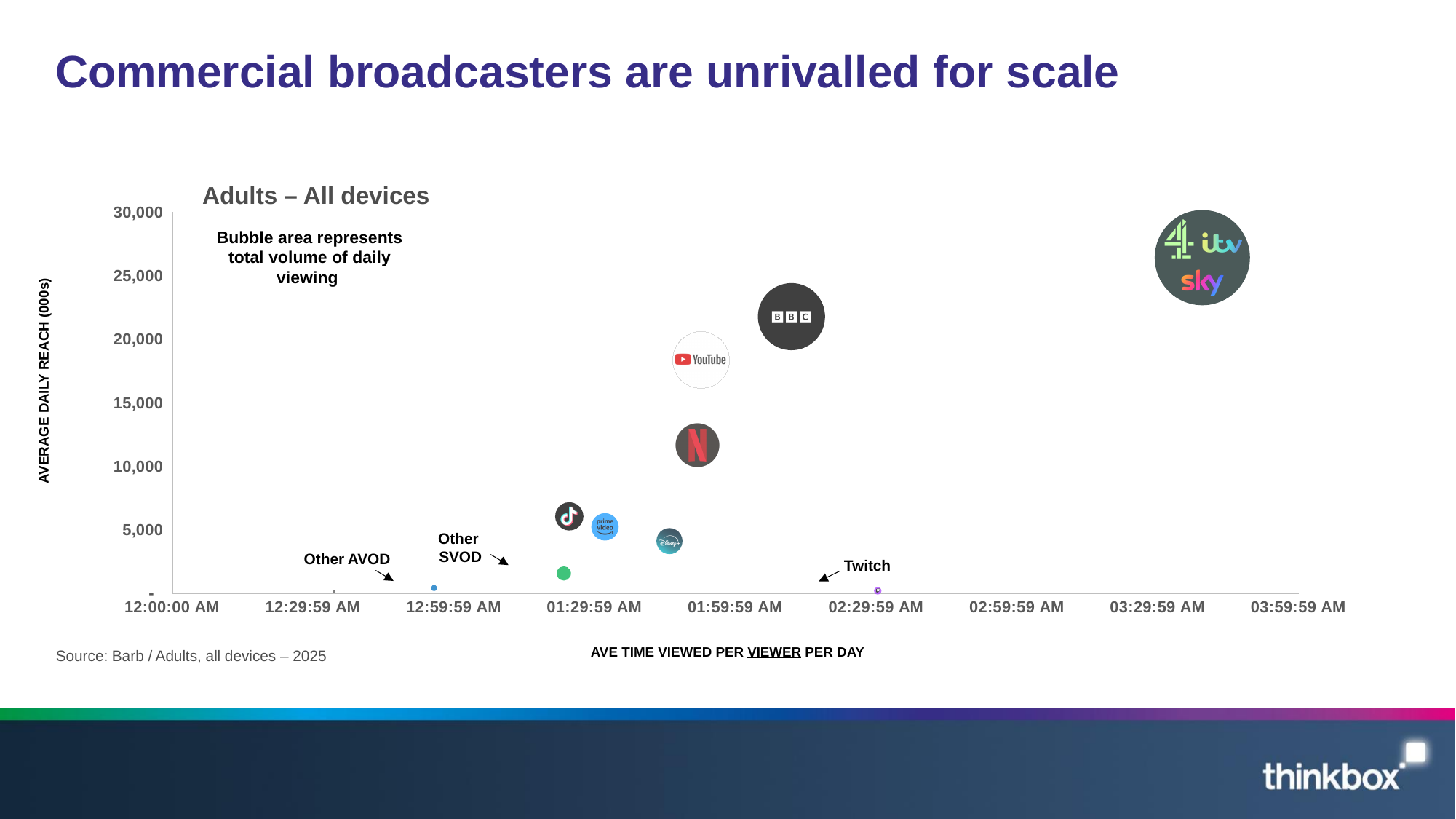
According to the chart note, what does the bubble area represent? Total volume of daily viewing How many bubbles are plotted on the chart? 11 Is the average daily reach for TikTok greater or less than 10,000? less Is the average daily reach for Netflix greater or less than 15,000? less What kind of chart is shown on the slide? Bubble chart Which has the higher average daily reach, Netflix or YouTube? YouTube Is the average daily reach for YouTube greater or less than 15,000? greater Which labelled bubble has the lowest average daily reach? Twitch Which has the higher average daily reach, BBC or YouTube? BBC Which bubble has the highest average daily reach? Channel 4 / ITV / Sky (commercial broadcasters)